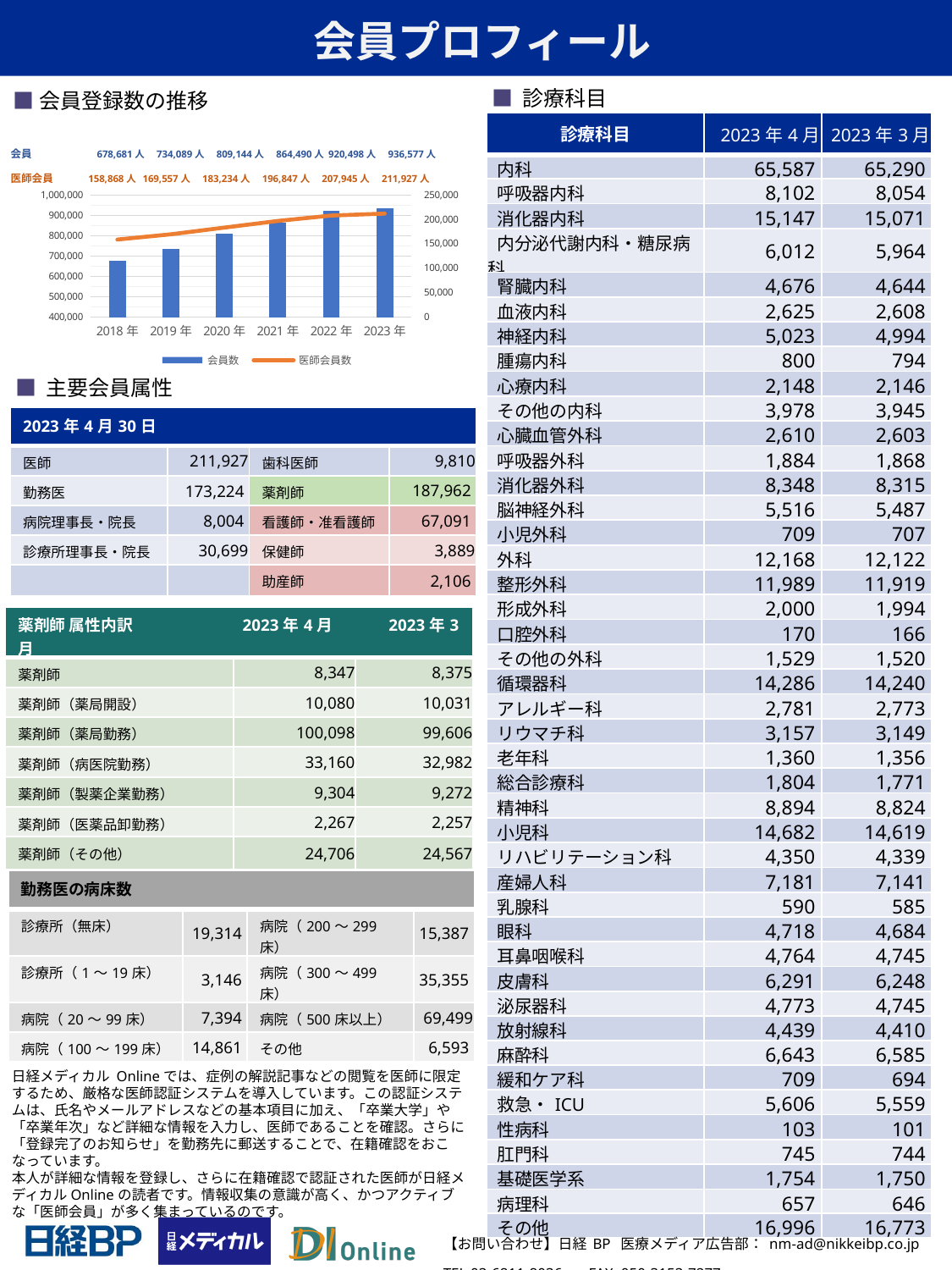
How many series does the legend of the 会員登録数の推移 chart list? 2 In the 会員登録数の推移 chart, what is the difference between the 会員 values for 2019年 and 2018年? 55,408人 In the 会員登録数の推移 chart, what was the 医師会員 value for 2021年? 196,847人 In the 会員登録数の推移 chart, what was the 会員 value for 2020年? 809,144人 What was the number of 医師会員 (physician members) in 2018年 in the 会員登録数の推移 chart? 158,868人 In the 会員登録数の推移 chart, what is the difference between the 医師会員 values for 2023年 and 2022年? 3,982人 How many years are shown on the x axis of the 会員登録数の推移 chart? 6 In the 会員登録数の推移 chart, is the 会員 value for 2022年 larger than the value for 2021年? Yes Which year has the lowest 医師会員 value in the 会員登録数の推移 chart? 2018年 What was the number of 会員 (members) in 2023年 according to the 会員登録数の推移 chart? 936,577人 Do the 会員 values rise or fall from 2018年 to 2023年 in the 会員登録数の推移 chart? Rise Which year has the highest 会員 value in the 会員登録数の推移 chart? 2023年